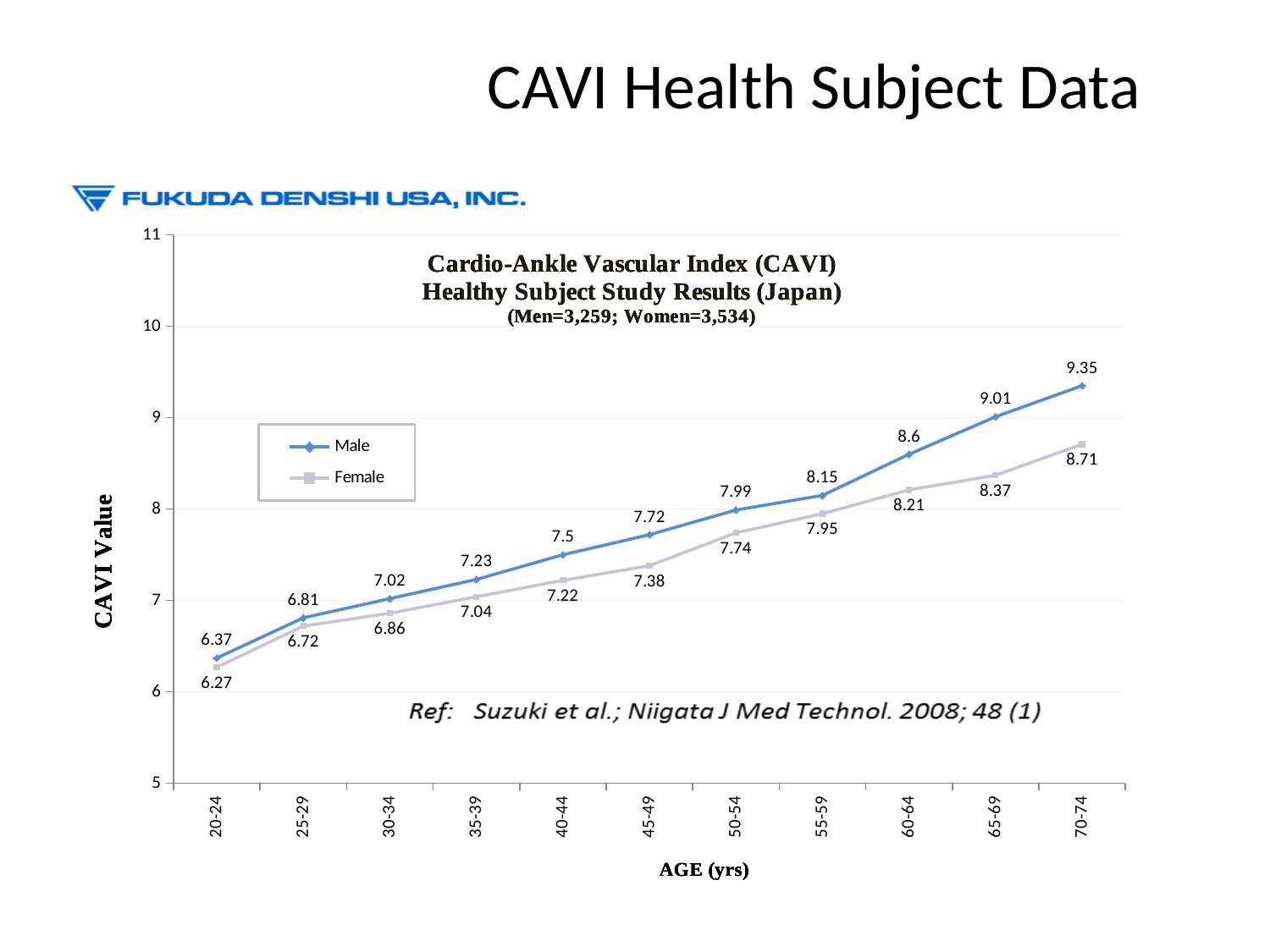
What is the Male CAVI value for the 40-44 age group? 7.5 What is the difference between the Male and Female CAVI values for the 70-74 age group? 0.64 What is the Male CAVI value for the 20-24 age group? 6.37 Which is larger for the 60-64 age group, the Male or the Female CAVI value? Male How many age groups are shown on the x axis? 11 Is the Male CAVI value for the 65-69 age group greater or less than 9? greater What is the Female CAVI value for the 55-59 age group? 7.95 Do the Male CAVI values rise or fall as age increases along the x axis? Rise How many series does the legend list? 2 Which age group has the lowest Male CAVI value? 20-24 What kind of chart is shown on the slide? Line chart Which age group has the highest Female CAVI value? 70-74